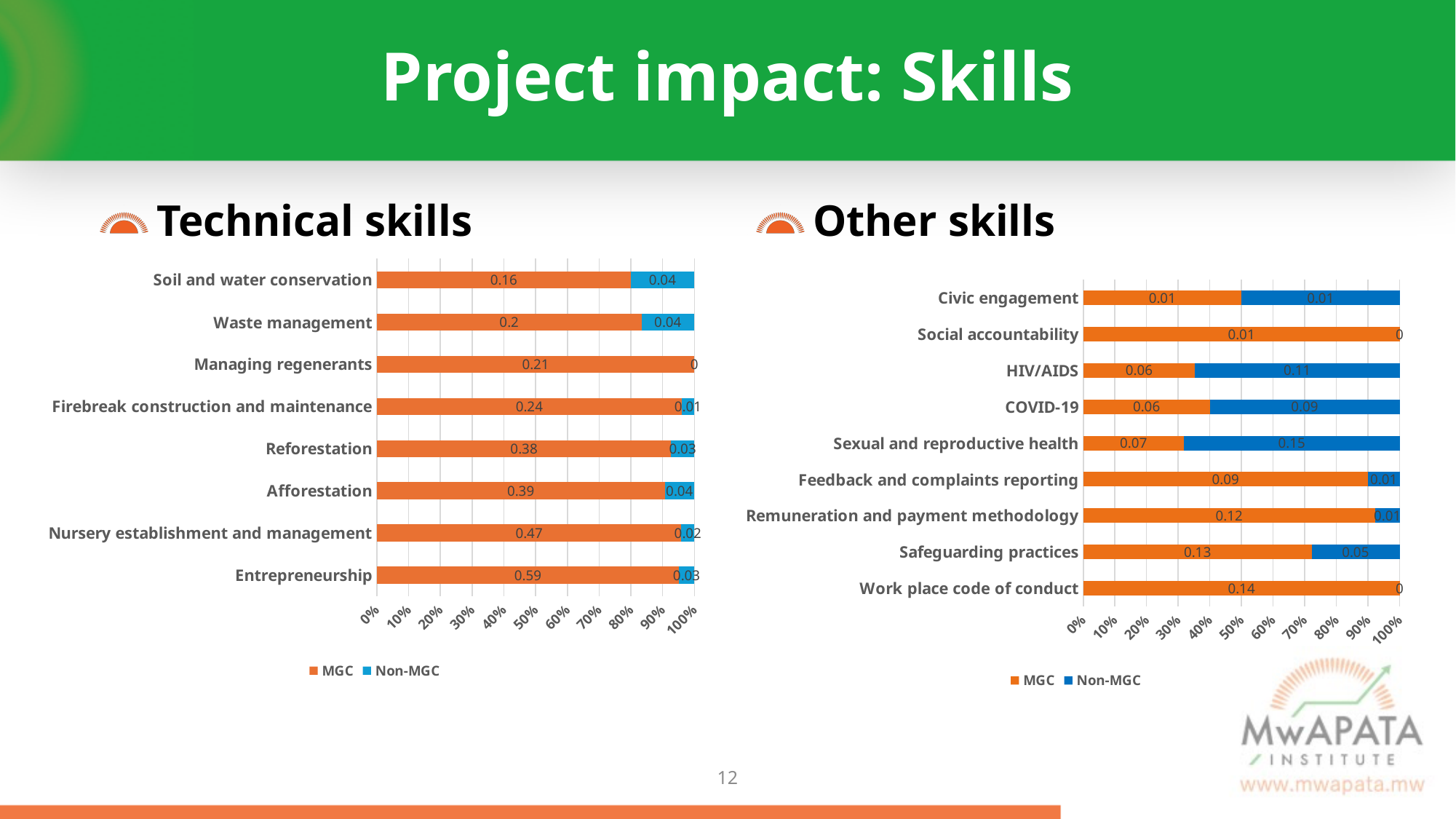
In the Other skills chart, which is larger for HIV/AIDS: the MGC value or the Non-MGC value? Non-MGC In the Technical skills chart, which category has the lowest MGC value? Soil and water conservation In the Other skills chart, what is the MGC value for Safeguarding practices? 0.13 How many series does the legend of the Other skills chart list? 2 In the Technical skills chart, what is the difference between the MGC values for Nursery establishment and management and Afforestation? 0.08 In the Other skills chart, which category has the highest Non-MGC value? Sexual and reproductive health In the Technical skills chart, what is the MGC value for Entrepreneurship? 0.59 In the Technical skills chart, which category has the highest MGC value? Entrepreneurship In the Other skills chart, what is the Non-MGC value for Sexual and reproductive health? 0.15 How many categories are shown in the Technical skills chart? 8 How many categories are shown in the Other skills chart? 9 In the Technical skills chart, what is the Non-MGC value for Waste management? 0.04